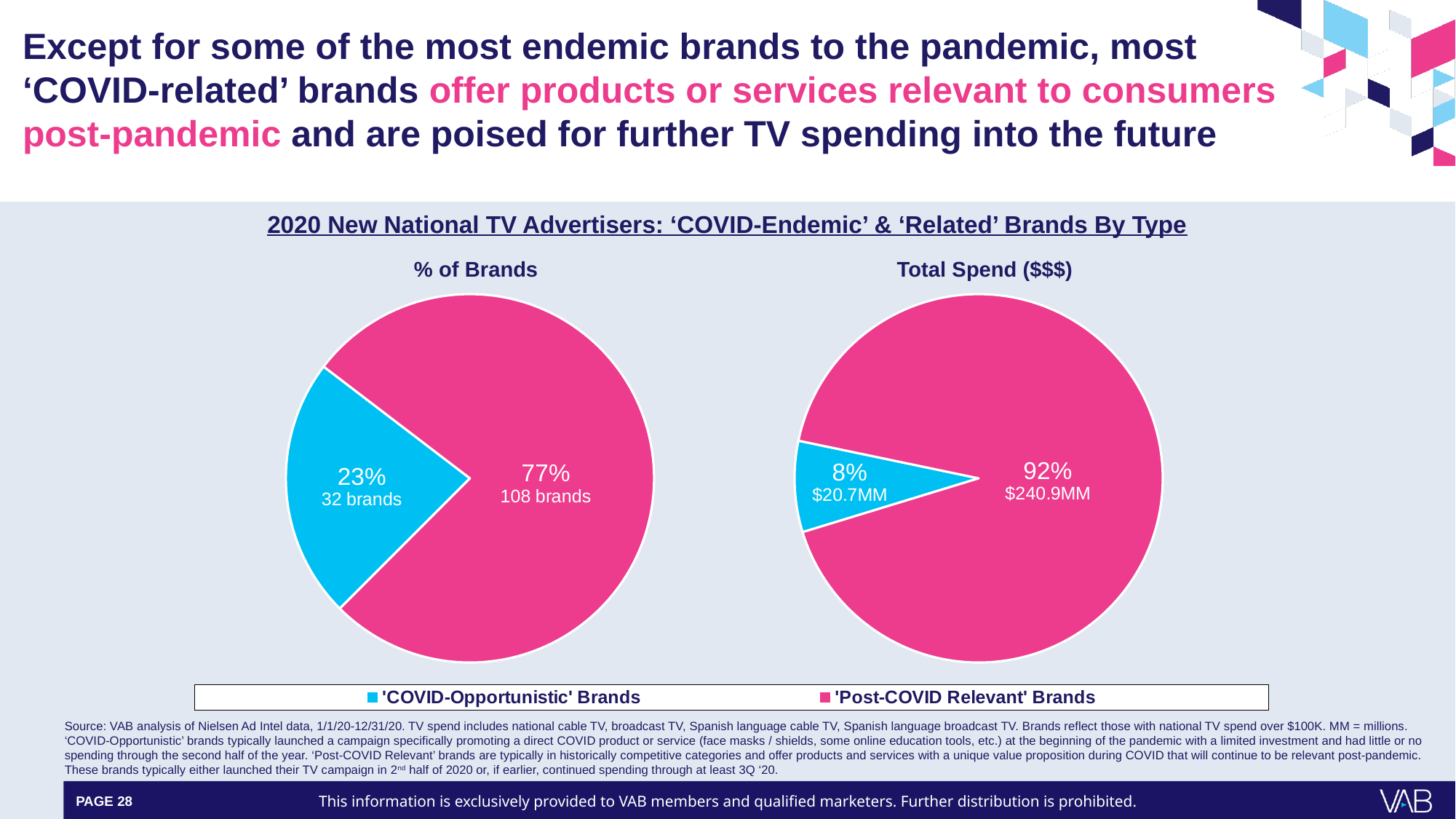
In the '% of Brands' pie chart, how many brands are 'Post-COVID Relevant' Brands? 108 brands In the '% of Brands' pie chart, how many more brands are 'Post-COVID Relevant' than 'COVID-Opportunistic'? 76 brands In the 'Total Spend ($$$)' pie chart, what is the total spend for 'COVID-Opportunistic' Brands? $20.7MM How many categories does the legend list for the pie charts? 2 In the 'Total Spend ($$$)' pie chart, what is the total spend for 'Post-COVID Relevant' Brands? $240.9MM In the '% of Brands' pie chart, what share of brands are 'COVID-Opportunistic' Brands? 23% In the 'Total Spend ($$$)' pie chart, what share of spend comes from 'COVID-Opportunistic' Brands? 8% In the '% of Brands' pie chart, how many brands are 'COVID-Opportunistic' Brands? 32 brands In the 'Total Spend ($$$)' pie chart, which category has the largest slice? 'Post-COVID Relevant' Brands What type of chart is used for 'Total Spend ($$$)'? Pie chart Which colour represents 'COVID-Opportunistic' Brands in the pie charts? Blue In the '% of Brands' pie chart, which category has the smallest slice? 'COVID-Opportunistic' Brands